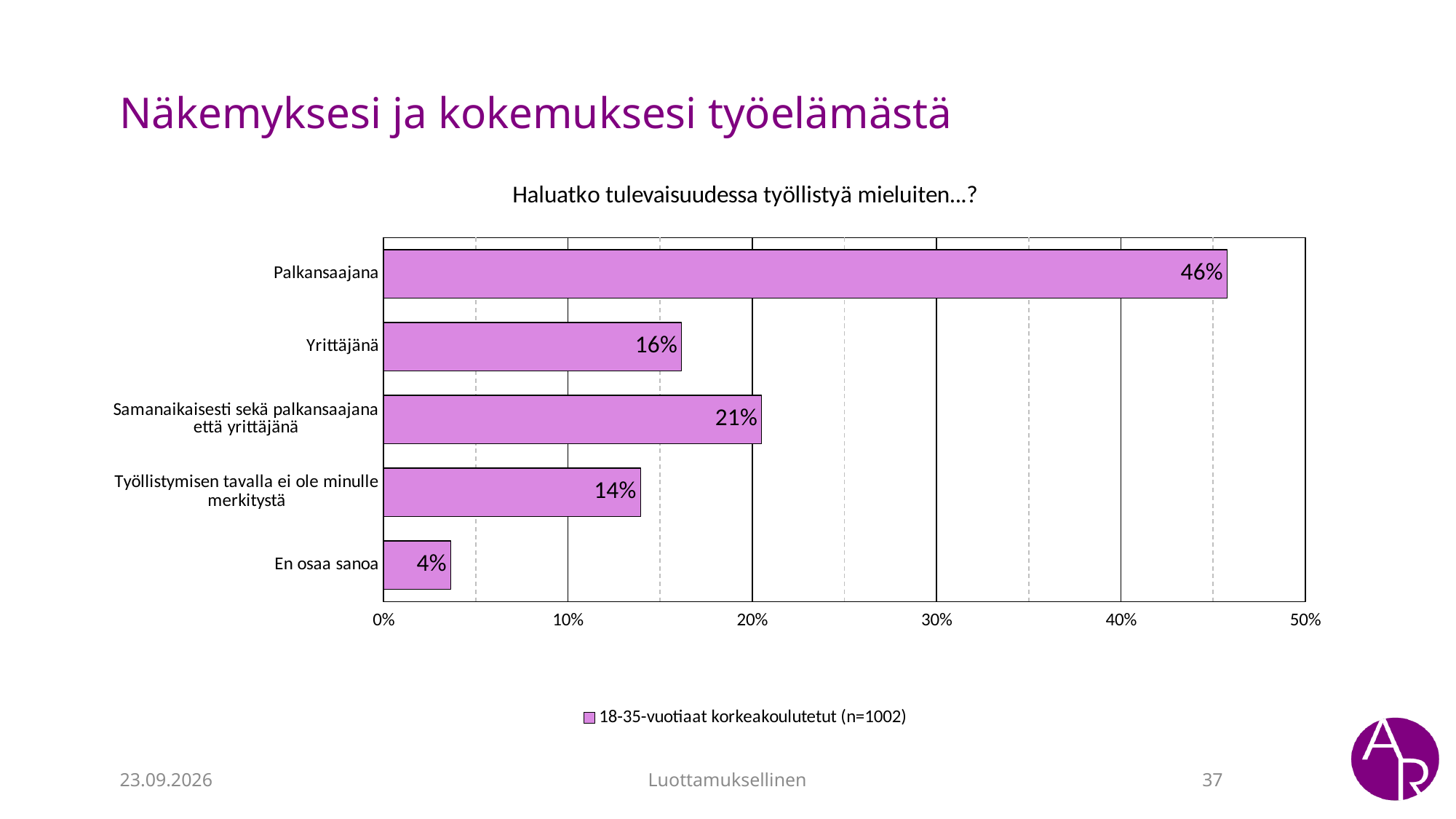
What is the difference between the values for Palkansaajana and Yrittäjänä? 30% What is the value for Samanaikaisesti sekä palkansaajana että yrittäjänä? 21% How many categories are shown in the chart? 5 Which category has the highest value? Palkansaajana What is the value for Palkansaajana? 46% What is the value for Työllistymisen tavalla ei ole minulle merkitystä? 14% What is the value for Yrittäjänä? 16% Which is larger, the value for Yrittäjänä or the value for Samanaikaisesti sekä palkansaajana että yrittäjänä? Samanaikaisesti sekä palkansaajana että yrittäjänä Which category has the lowest value? En osaa sanoa What is the value for En osaa sanoa? 4% What is the title of the chart? Haluatko tulevaisuudessa työllistyä mieluiten…? What kind of chart is shown on the slide? Bar chart